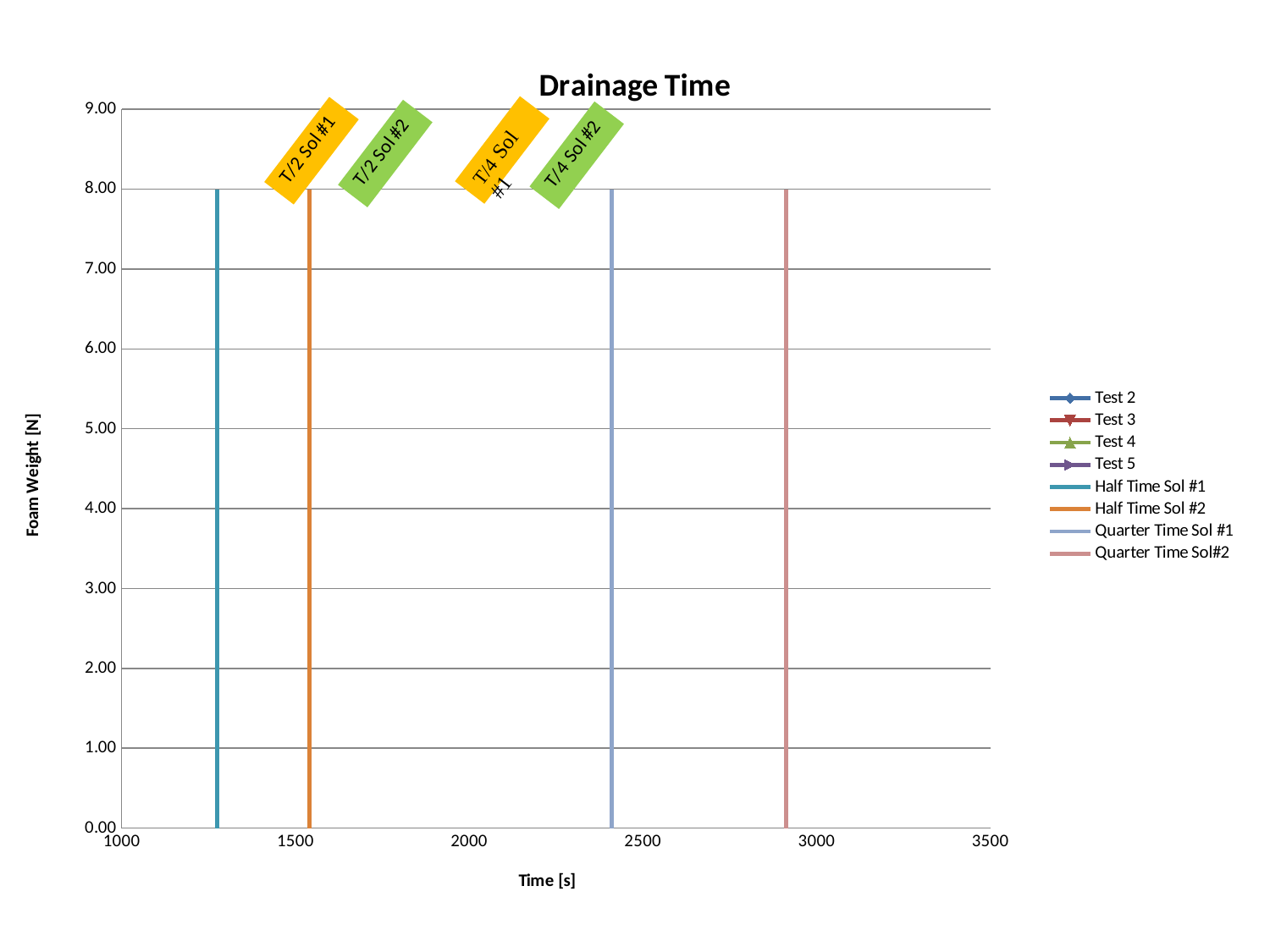
How many vertical lines are plotted on the chart? 4 Which series' vertical line is drawn at the smallest time value? Half Time Sol #1 Is the time at which the Half Time Sol #2 vertical line is drawn greater or less than 1500? greater Is the time at which the Quarter Time Sol#2 vertical line is drawn greater or less than 3000? less Which vertical line is at a larger time value, Half Time Sol #2 or Quarter Time Sol #1? Quarter Time Sol #1 What kind of chart is shown on the slide? line chart How many series does the legend list? 8 Which series' vertical line is drawn at the largest time value? Quarter Time Sol#2 Is the time at which the Quarter Time Sol #1 vertical line is drawn greater or less than 2500? less What is the title of the chart? Drainage Time What is the label of the x axis? Time [s]